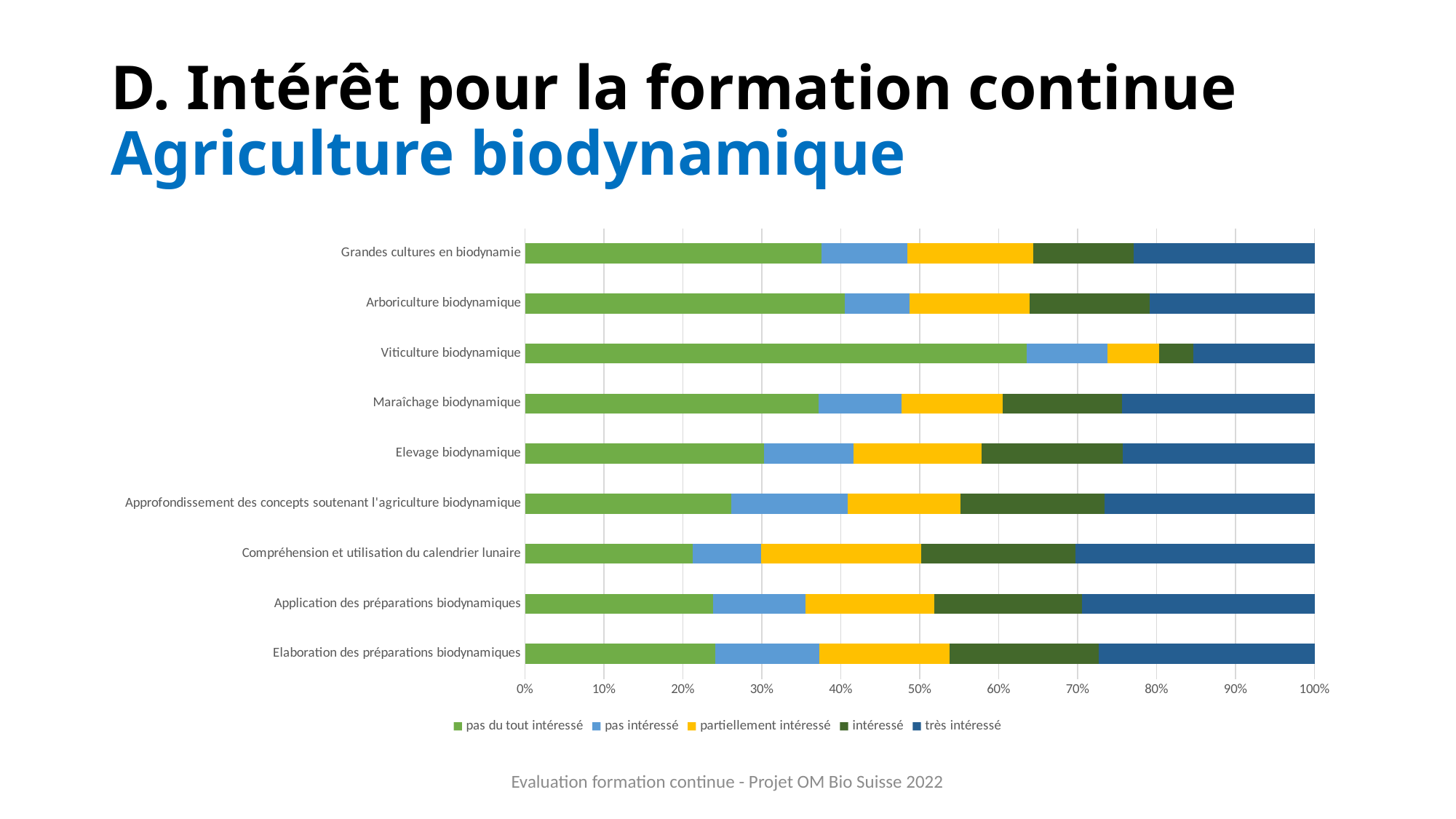
What kind of chart is shown on the slide? stacked bar chart What is the first entry listed in the chart legend? pas du tout intéressé How many categories (training topics) are plotted on the chart? 9 What does each stacked bar total on the x axis? 100% Which category has the smallest 'pas du tout intéressé' share? Compréhension et utilisation du calendrier lunaire Is the 'pas du tout intéressé' share for Viticulture biodynamique greater or less than 60%? greater Which has the larger 'pas du tout intéressé' share: Viticulture biodynamique or Arboriculture biodynamique? Viticulture biodynamique How many series does the legend list? 5 Which has the larger 'très intéressé' share: Compréhension et utilisation du calendrier lunaire or Viticulture biodynamique? Compréhension et utilisation du calendrier lunaire Which category has the largest 'pas du tout intéressé' share? Viticulture biodynamique Is the 'pas du tout intéressé' share for Grandes cultures en biodynamie greater or less than 40%? less Is the 'pas du tout intéressé' share for Compréhension et utilisation du calendrier lunaire greater or less than 30%? less